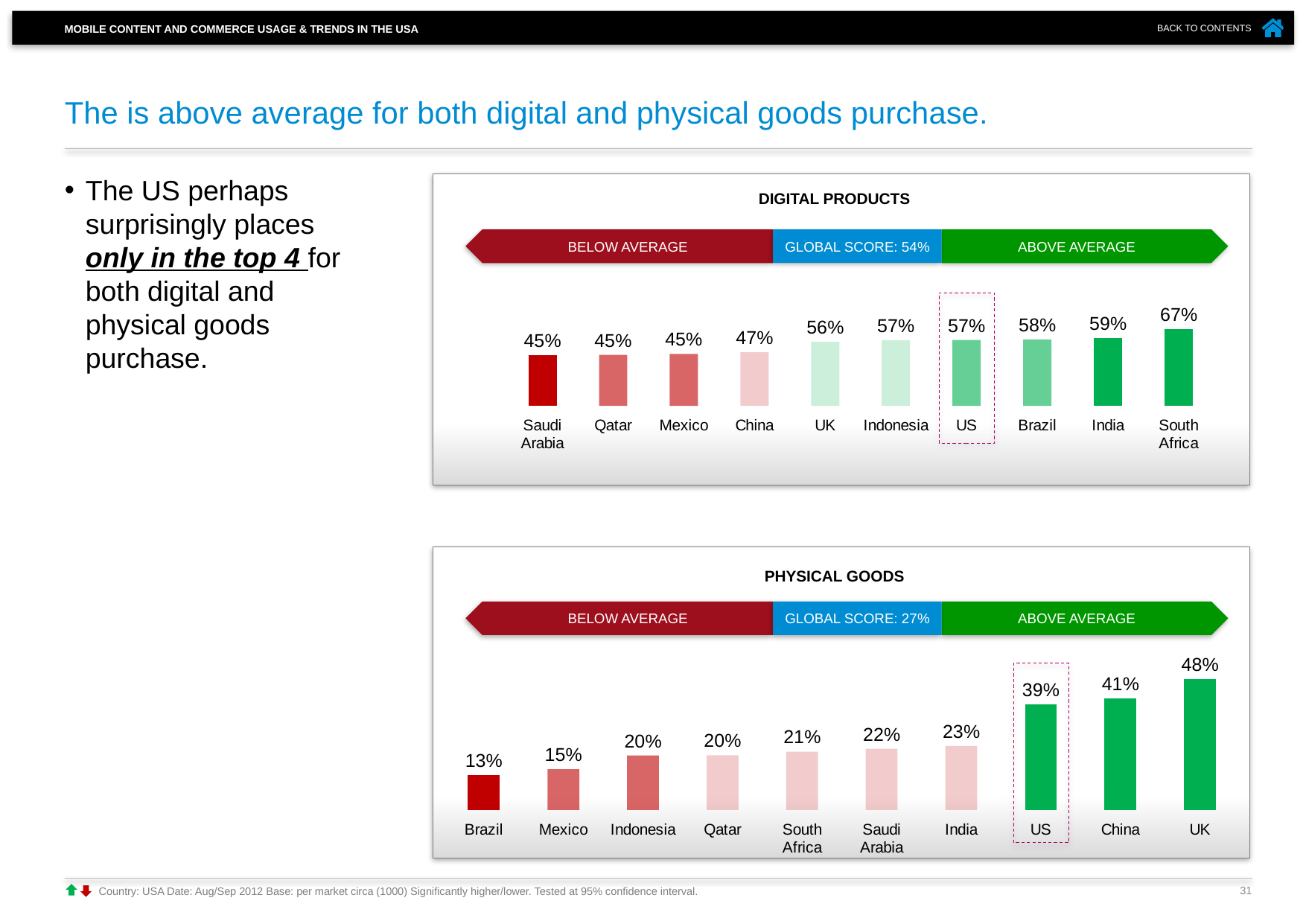
In the DIGITAL PRODUCTS chart, what is the value for the US? 57% In the DIGITAL PRODUCTS chart, how many countries are shown? 10 In the DIGITAL PRODUCTS chart, what is the global score shown? 54% In the DIGITAL PRODUCTS chart, what is the difference between South Africa and Saudi Arabia? 22% In the PHYSICAL GOODS chart, which is larger, the value for China or the value for US? China In the PHYSICAL GOODS chart, which country has the lowest value? Brazil In the PHYSICAL GOODS chart, what is the value for Brazil? 13% What kind of chart is the PHYSICAL GOODS chart? bar chart In the PHYSICAL GOODS chart, which country has the highest value? UK In the DIGITAL PRODUCTS chart, which country has the highest value? South Africa In the PHYSICAL GOODS chart, do the values rise or fall from left to right? rise In the PHYSICAL GOODS chart, what is the difference between the UK and the US? 9%